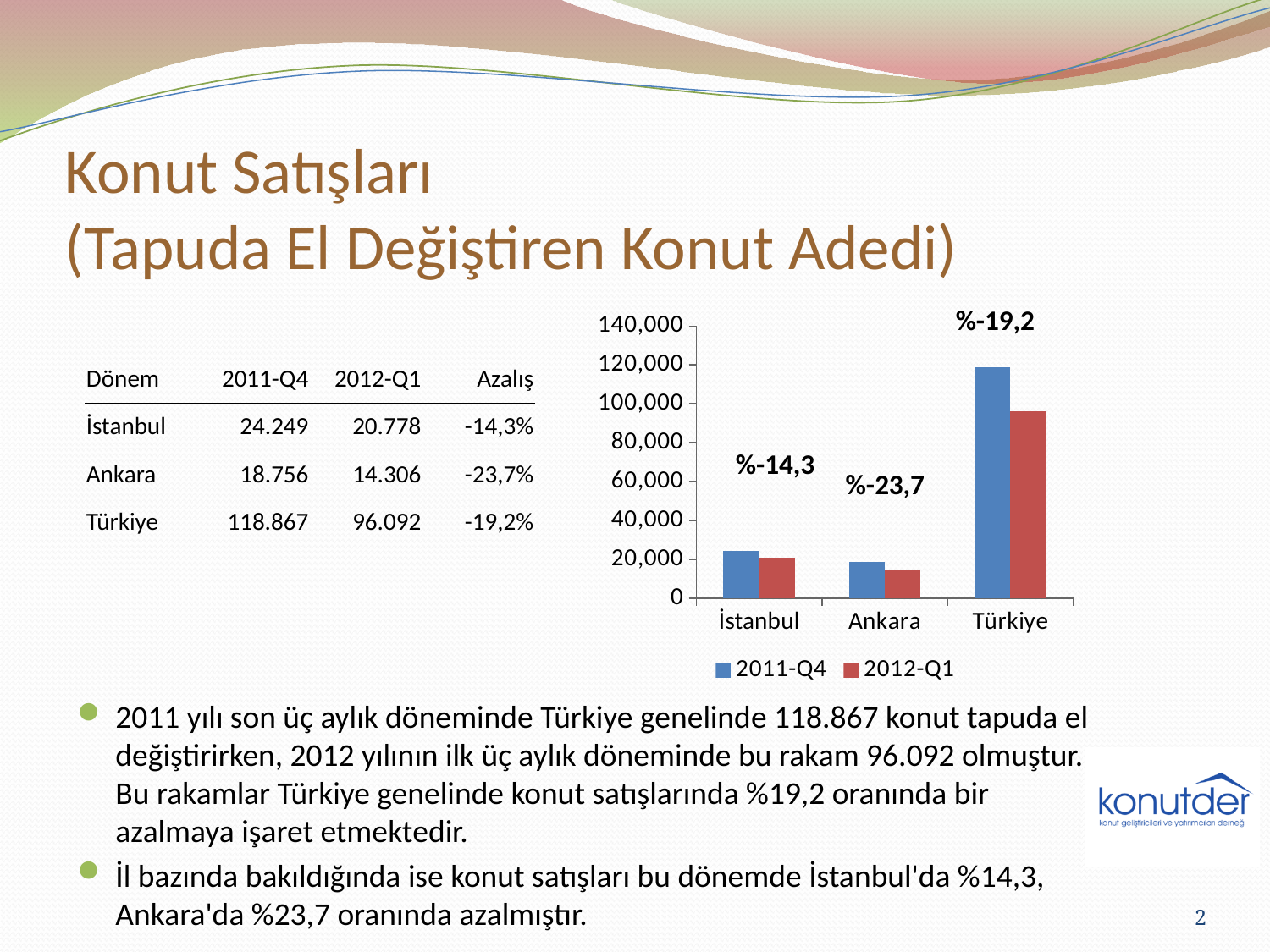
Which category has the highest 2011-Q4 value in the chart? Türkiye What kind of chart is shown on the slide? bar chart Is the 2012-Q1 value for Ankara greater or less than 20,000? less How many series does the chart legend list? 2 Is the 2011-Q4 value for İstanbul greater or less than 20,000? greater Which category has the lowest 2012-Q1 value in the chart? Ankara What percentage change is labelled above the Ankara bars in the chart? %-23,7 How many categories are shown on the x axis of the chart? 3 What percentage change is labelled above the Türkiye bars in the chart? %-19,2 Which series is shown in red in the chart? 2012-Q1 Is the 2011-Q4 value for Türkiye greater or less than 100,000? greater For Türkiye, which is larger: the 2011-Q4 bar or the 2012-Q1 bar? 2011-Q4